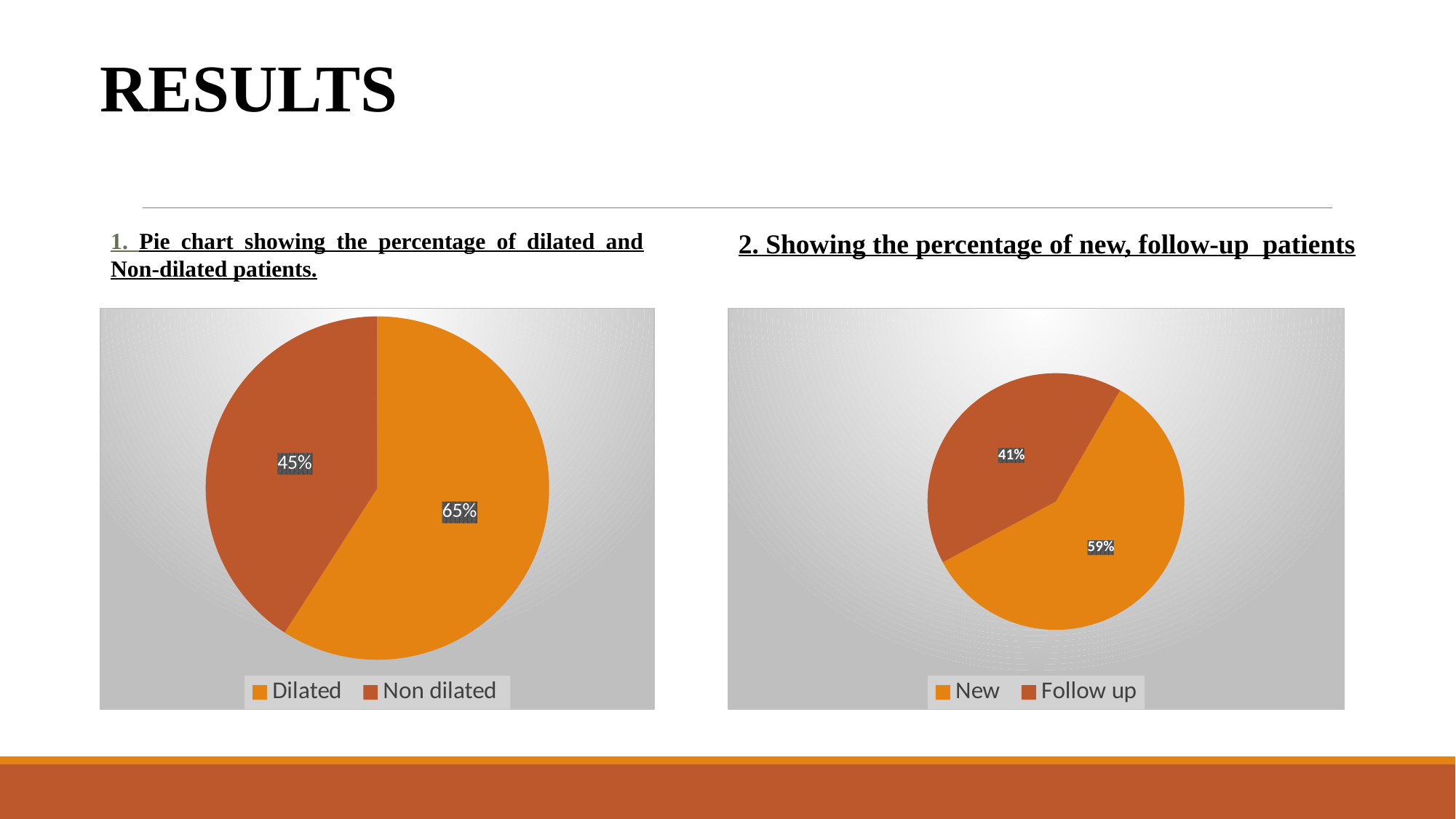
In the left pie chart (dilated and non-dilated patients), what percentage is shown for Non dilated? 45% What type of chart is the chart on the right of the slide? pie chart In the right pie chart, which colour represents the New category? orange In the right pie chart, what is the difference between the New and Follow up percentages? 18% In the right pie chart (new and follow-up patients), what percentage is shown for New? 59% In the left pie chart, which category has the larger slice? Dilated In the left pie chart, is the Non dilated slice larger or smaller than the Dilated slice? smaller In the right pie chart (new and follow-up patients), what percentage is shown for Follow up? 41% How many slices does the left pie chart have? 2 How many entries does the legend of the right pie chart list? 2 In the left pie chart (dilated and non-dilated patients), what percentage is shown for Dilated? 65% In the right pie chart, which category has the smaller slice? Follow up